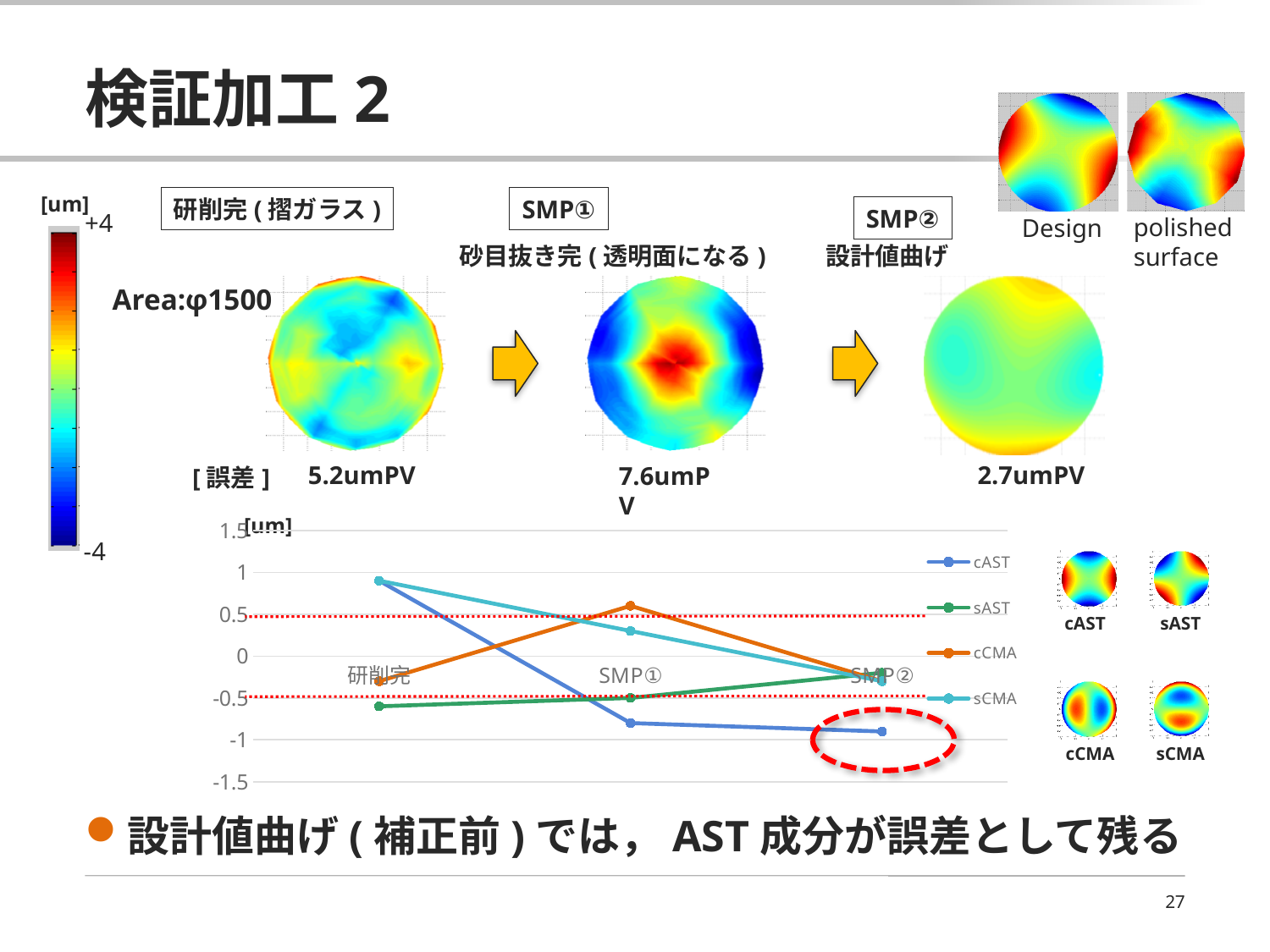
In the line chart, is the value for cAST at SMP① greater or less than -0.5? less How many categories are on the x axis of the line chart? 3 In the line chart, which series has the lowest value at SMP①? cAST In the line chart, which series has the highest value at SMP①? cCMA In the line chart, does the cAST series rise or fall from 研削完 to SMP②? fall In the line chart, is the value for sCMA at 研削完 greater or less than 0.5? greater What are the four series names in the legend of the line chart? cAST, sAST, cCMA, sCMA How many series does the legend of the line chart list? 4 What unit is shown at the top of the y axis of the line chart? [um] In the line chart, is the value for sAST at 研削完 greater or less than 0? less What kind of chart is shown at the bottom of the slide? line chart